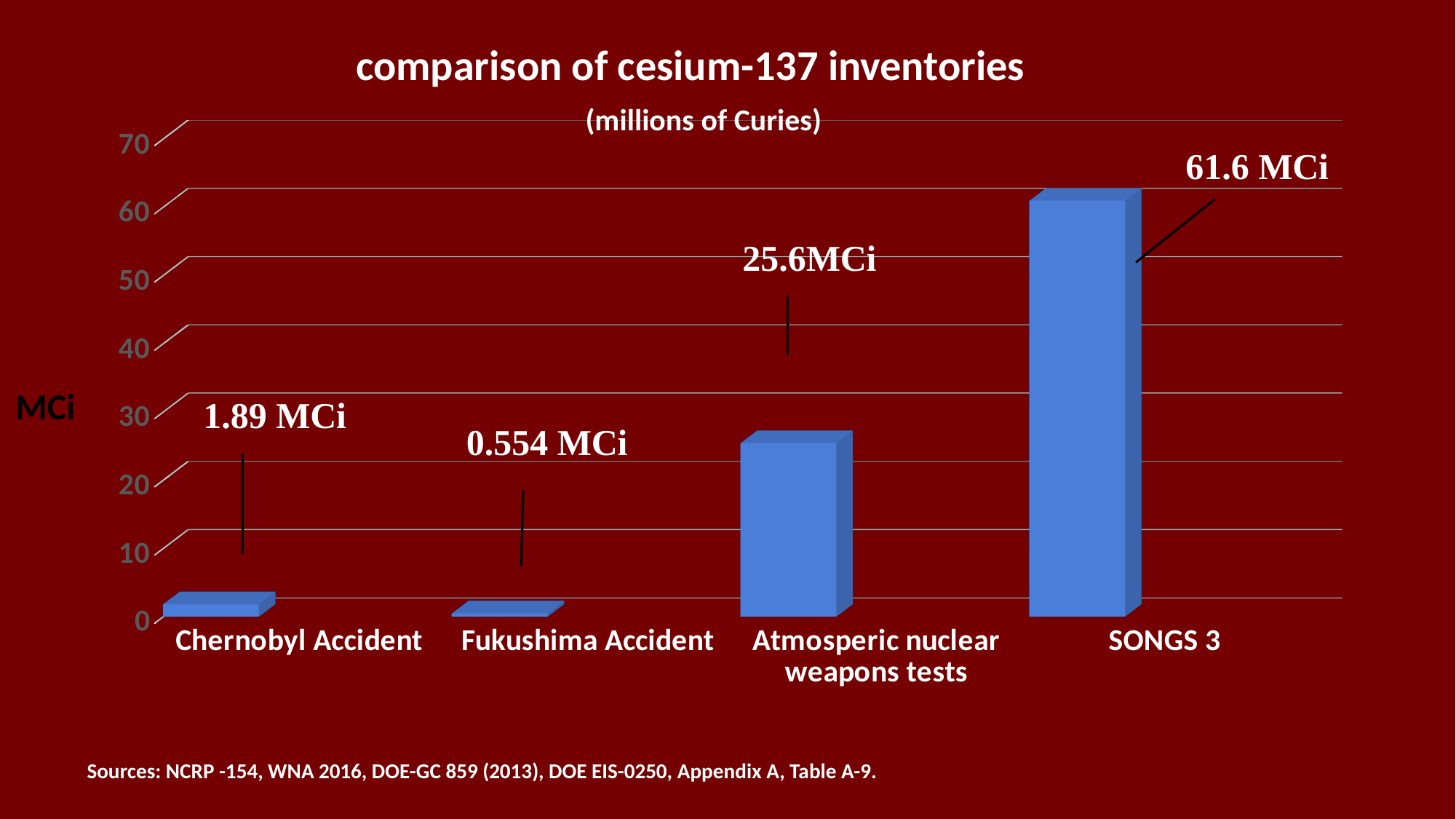
What is the title of the chart? comparison of cesium-137 inventories Which category has the highest cesium-137 inventory? SONGS 3 How much larger is the SONGS 3 value than the Atmosperic nuclear weapons tests value, in MCi? 36 MCi Which category has the lowest cesium-137 inventory? Fukushima Accident What value is labelled for Atmosperic nuclear weapons tests? 25.6MCi What value is labelled for the Fukushima Accident bar? 0.554 MCi What is the cesium-137 inventory shown for SONGS 3? 61.6 MCi Which is larger, the value for the Chernobyl Accident or the value for the Fukushima Accident? Chernobyl Accident Is the value for SONGS 3 greater or less than 50? greater What is the difference between the Chernobyl Accident and Fukushima Accident values, in MCi? 1.336 MCi How many categories are plotted on the chart? 4 What is the cesium-137 inventory shown for the Chernobyl Accident? 1.89 MCi